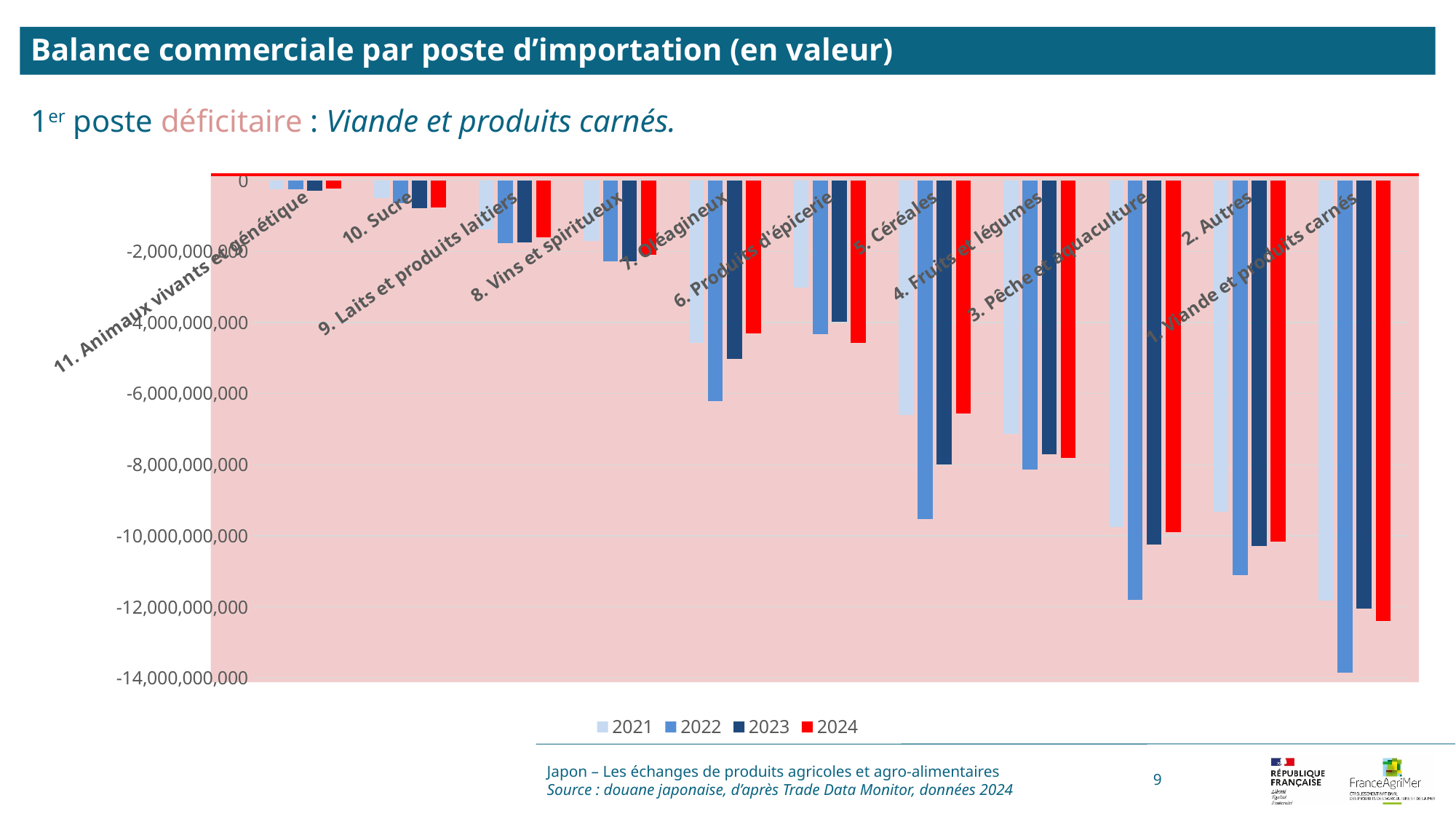
Which shows a larger deficit (more negative value) in 2022: 1. Viande et produits carnés or 2. Autres? 1. Viande et produits carnés Which category has the bars closest to zero (smallest deficit)? 11. Animaux vivants et génétique Which years are listed in the legend? 2021, 2022, 2023, 2024 Which category has the most negative (largest deficit) bar in the chart? 1. Viande et produits carnés Is the 2022 value for 1. Viande et produits carnés greater or less than -12,000,000,000? less Moving from left to right along the x axis, do the values generally rise or fall? fall Is the 2022 value for 2. Autres greater or less than -12,000,000,000? greater How many series does the legend list? 4 How many import categories are shown on the x axis? 11 Is the 2021 value for 10. Sucre greater or less than -2,000,000,000? greater What is the title of the slide containing the chart? Balance commerciale par poste d'importation (en valeur) What kind of chart is shown on the slide? bar chart